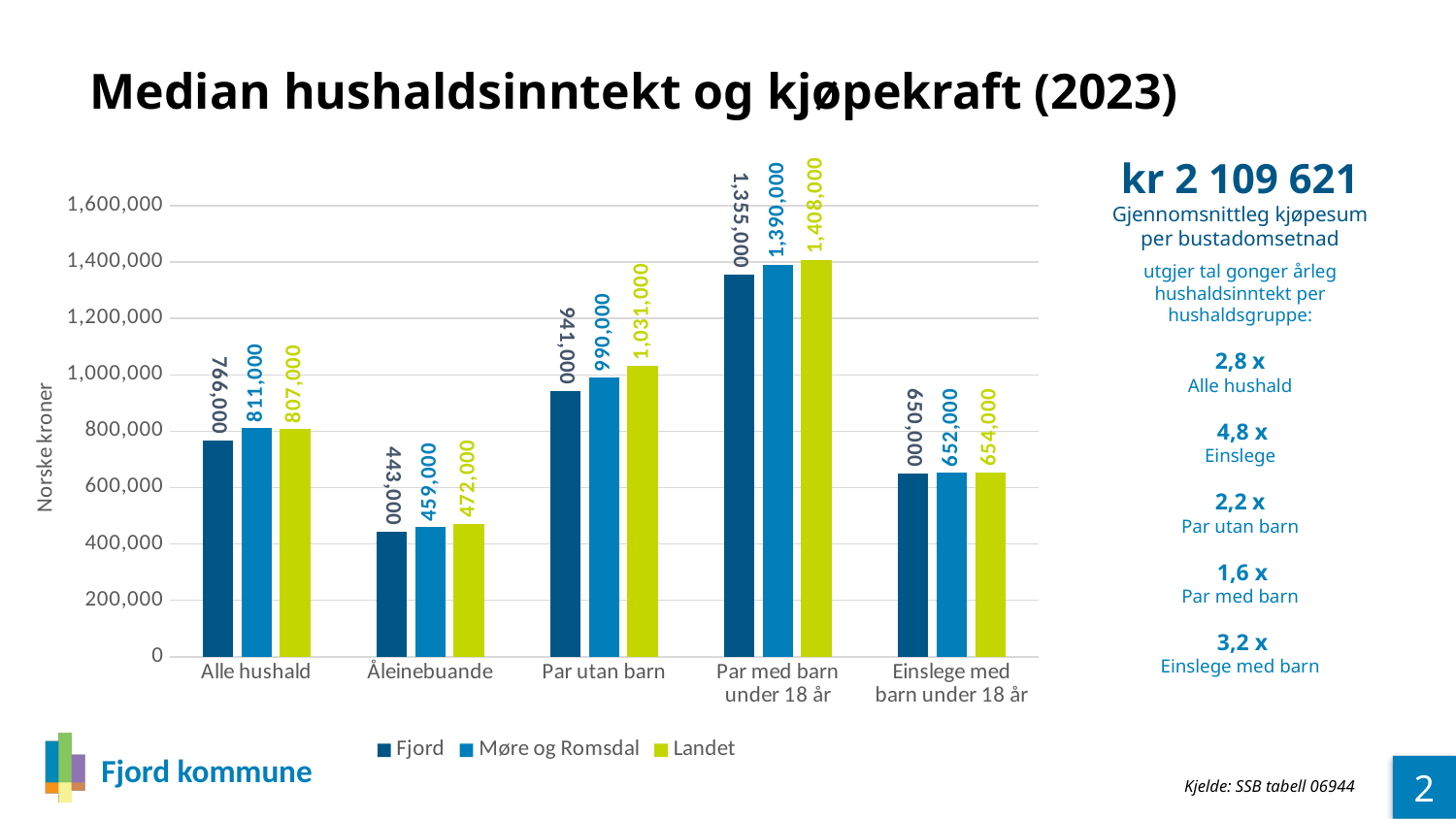
What is the value for Fjord in the Alle hushald category? 766,000 What kind of chart is shown on the slide? bar chart Which is larger in the Alle hushald category: Møre og Romsdal or Landet? Møre og Romsdal What is the difference between the Landet and Fjord values in the Par med barn under 18 år category? 53,000 Is the value for Fjord in the Par utan barn category greater or less than 1,000,000? less How many categories are shown on the x axis? 5 Which category has the lowest value for Landet? Åleinebuande Which category has the highest value for Fjord? Par med barn under 18 år What is the label of the y axis? Norske kroner What is the value for Landet in the Par utan barn category? 1,031,000 What is the value for Møre og Romsdal in the Åleinebuande category? 459,000 How many series does the legend list? 3